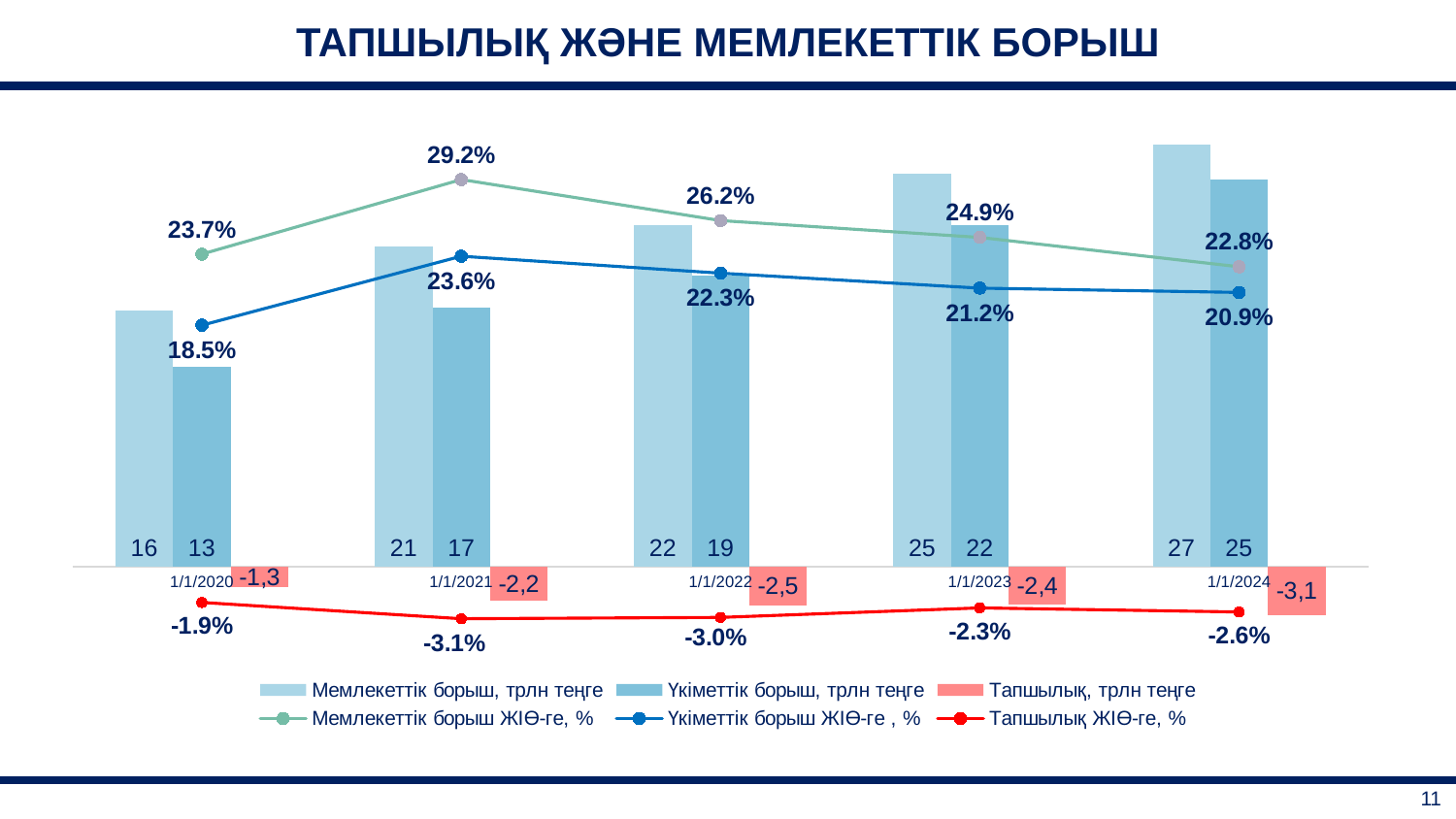
In which year does Мемлекеттік борыш ЖІӨ-ге, % reach its highest value? 1/1/2021 What is the value of Тапшылық, трлн теңге for 1/1/2024? -3,1 In which year is Үкіметтік борыш ЖІӨ-ге, % lowest? 1/1/2020 What is the value of Үкіметтік борыш, трлн теңге for 1/1/2021? 17 Does Мемлекеттік борыш, трлн теңге rise or fall from 1/1/2020 to 1/1/2024? rise Which is larger for 1/1/2021: Мемлекеттік борыш ЖІӨ-ге, % or Үкіметтік борыш ЖІӨ-ге, %? Мемлекеттік борыш ЖІӨ-ге, % What is the value of Тапшылық ЖІӨ-ге, % for 1/1/2023? -2.3% What is the difference between Мемлекеттік борыш, трлн теңге and Үкіметтік борыш, трлн теңге for 1/1/2023? 3 What is the value of Мемлекеттік борыш, трлн теңге for 1/1/2024? 27 How many series does the legend list? 6 How many dates are shown on the x axis of the chart? 5 What is the value of Мемлекеттік борыш ЖІӨ-ге, % for 1/1/2022? 26.2%